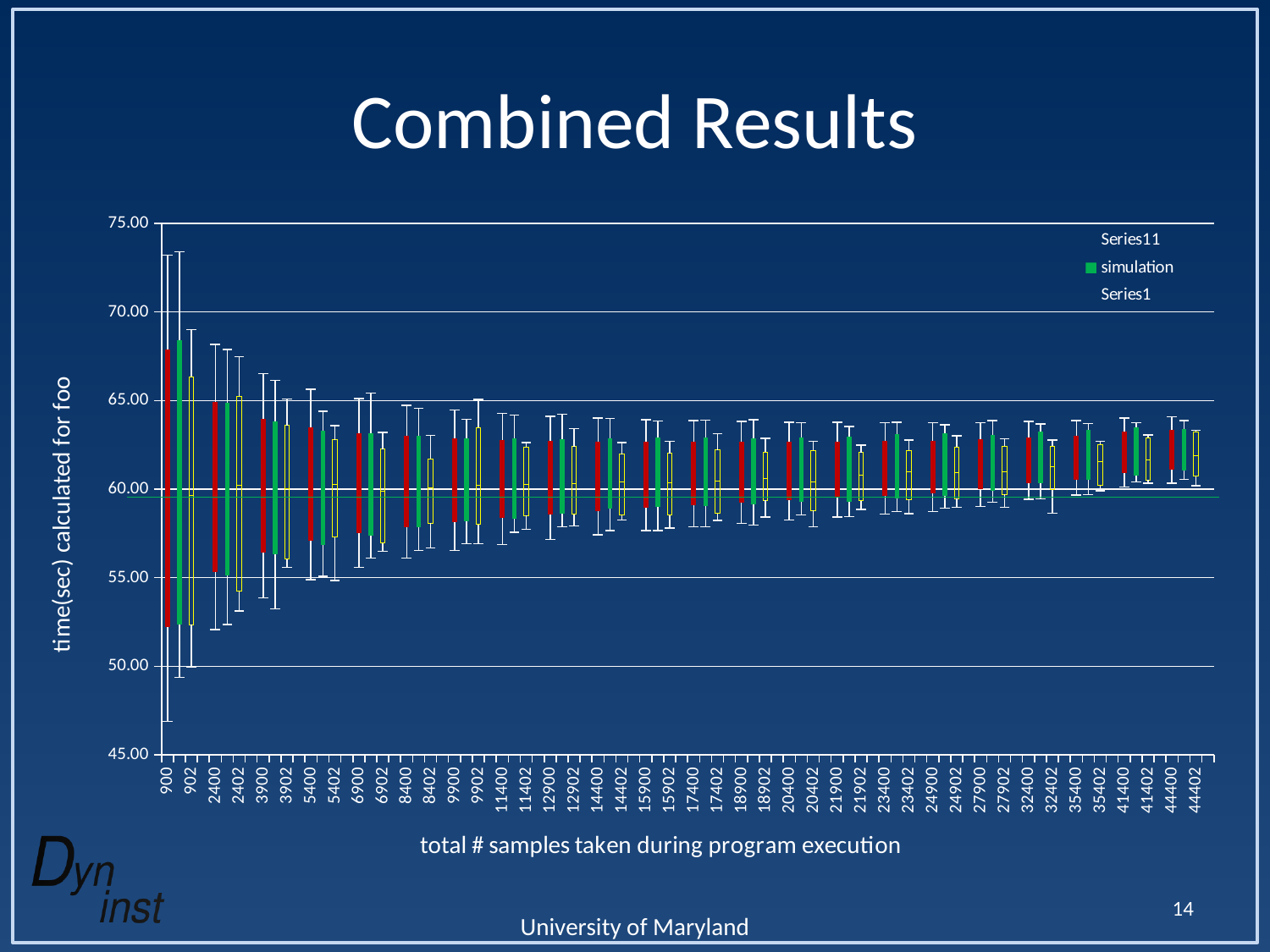
How many entries does the chart legend list? 3 What is the title of the chart? Combined Results What is the first category label on the x axis of the chart? 900 What is the highest value shown on the y axis of the chart? 75.00 Is the upper end of the whisker for the 900 category greater or less than 70.00? greater Which category has the widest spread between its whisker ends, 900 or 44400? 900 Is the lower end of the whisker for the 900 category greater or less than 50.00? less Is the bottom of the red box for the 900 category greater or less than 55.00? less As the total number of samples increases along the x axis, does the spread of the plotted values narrow or widen? narrow What is the label on the y axis of the chart? time(sec) calculated for foo What is the lowest value shown on the y axis of the chart? 45.00